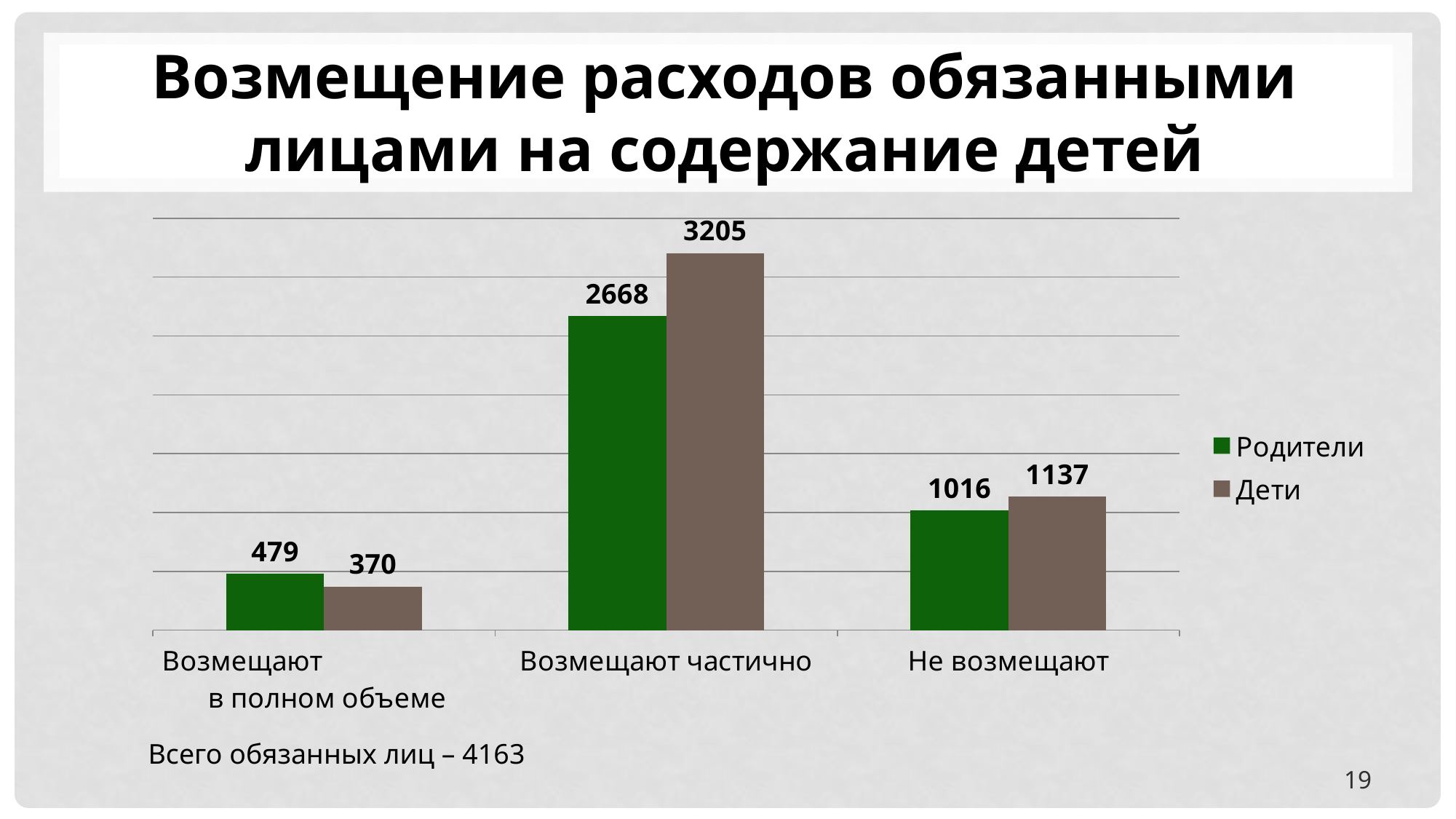
In the category Не возмещают, which series has the larger value, Родители or Дети? Дети How many categories are shown on the x axis? 3 What kind of chart is shown on the slide? Bar chart Which category has the highest value for the Дети series? Возмещают частично What is the difference between the Родители and Дети values in the category Возмещают в полном объеме? 109 Which category has the lowest value for the Родители series? Возмещают в полном объеме Which colour represents the Родители series in the legend? Green What is the value for Родители in the category Возмещают частично? 2668 What is the difference between the Дети and Родители values in the category Возмещают частично? 537 How many series does the legend list? 2 What is the value for Дети in the category Возмещают в полном объеме? 370 What is the value for Дети in the category Не возмещают? 1137